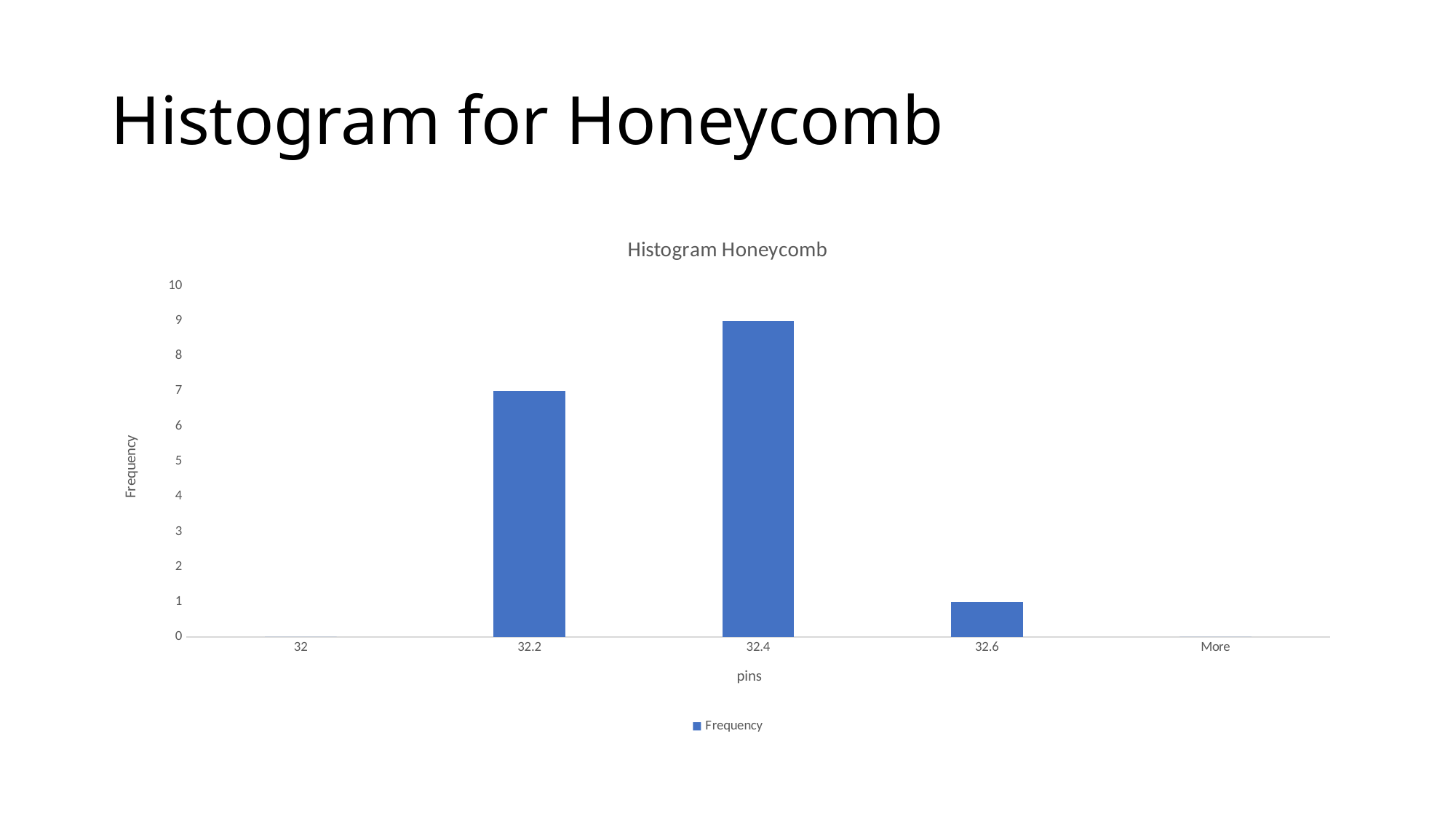
What is the title of the chart? Histogram Honeycomb What is the frequency for the 32.4 bin? 9 What is the frequency for the 32.2 bin? 7 How many series does the legend list? 1 Is the frequency for the 32.4 bin greater or less than 5? greater What kind of chart is shown on the slide? Bar chart How many bins are shown on the x axis? 5 What is the frequency for the 32.6 bin? 1 Which bin has the lowest non-zero frequency? 32.6 What is the difference in frequency between the 32.4 bin and the 32.2 bin? 2 Which bin has a larger frequency, 32.2 or 32.6? 32.2 Which bin has the highest frequency? 32.4